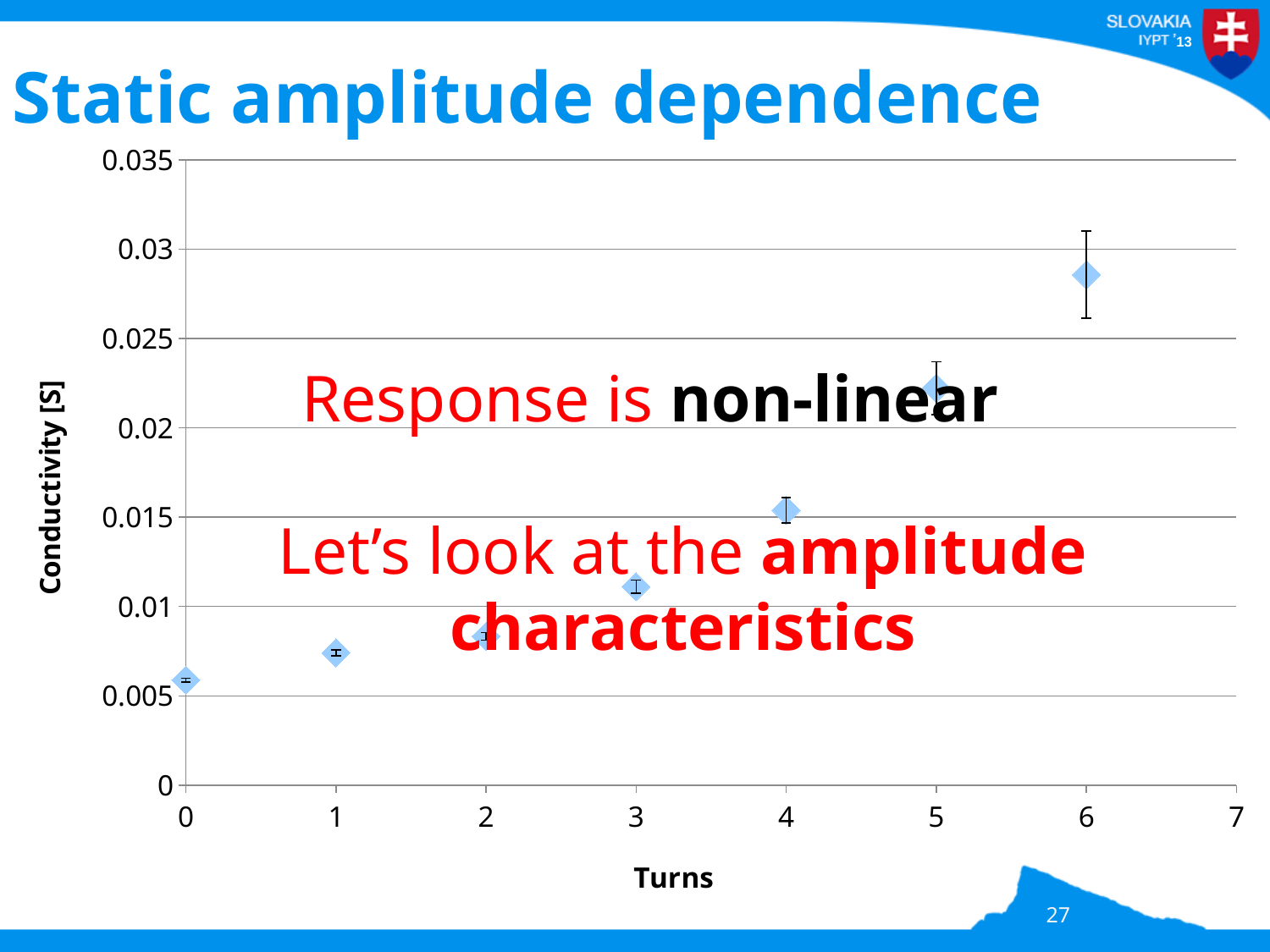
Which has the larger conductivity, 4 turns or 2 turns? 4 turns What is the label of the x axis? Turns How many data points are plotted on the chart? 7 Do the conductivity values rise or fall as the number of turns increases? rise What kind of chart is shown on the slide? scatter chart Is the conductivity at 6 turns greater or less than 0.025? greater Is the conductivity at 5 turns greater or less than 0.02? greater Is the conductivity at 0 turns greater or less than 0.01? less At which number of turns is the conductivity lowest? 0 What is the label of the y axis? Conductivity [S] At which number of turns is the conductivity highest? 6